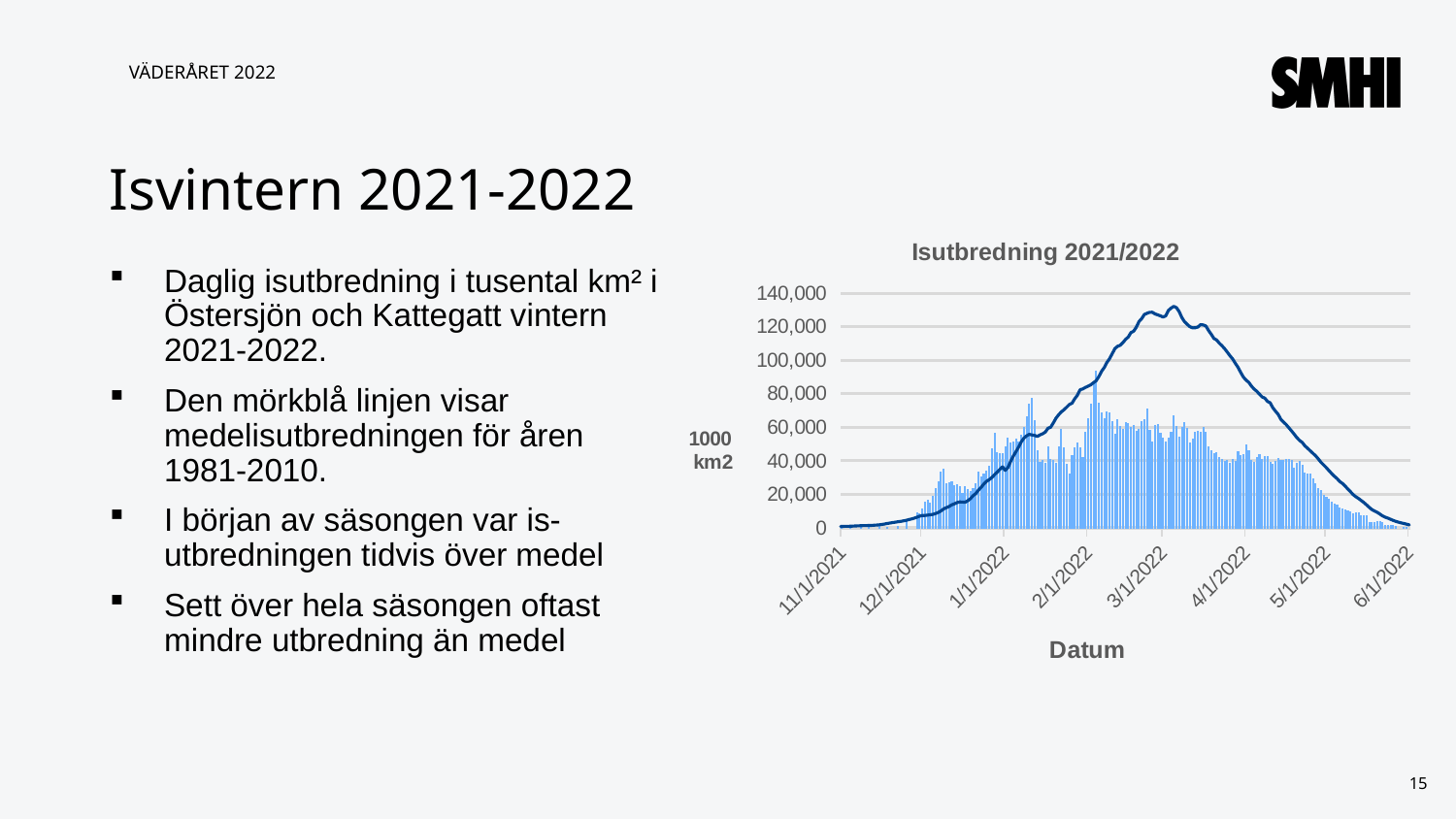
Is the peak value of the dark blue line greater or less than 120,000? greater What is the label of the x axis of the chart? Datum Near which x-axis date does the dark blue line reach its highest value? 3/1/2022 Is the peak value of the dark blue line greater or less than 140,000? less What is the title of the chart on the slide? Isutbredning 2021/2022 What is the highest value shown on the y axis of the chart? 140,000 Around 3/1/2022, which is larger: the dark blue line or the light blue bars? the dark blue line What type of chart is shown on the slide? Combined bar and line chart Is the value of the dark blue line at 5/1/2022 greater or less than 60,000? less Does the dark blue line rise or fall between 3/1/2022 and 6/1/2022? fall How many date labels are shown along the x axis of the chart? 8